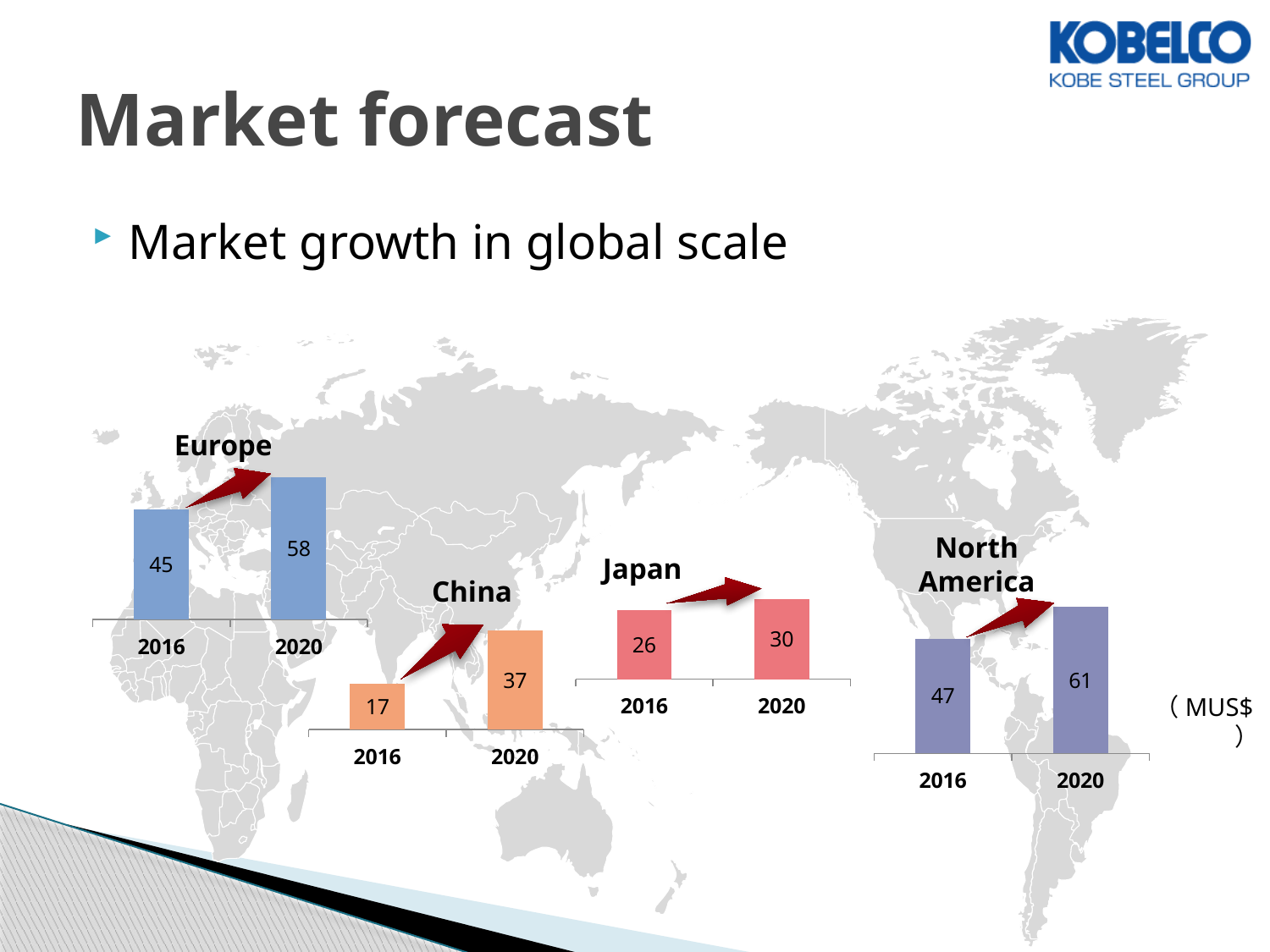
In the Europe chart, what is the value for 2020? 58 How many bars does the China chart show? 2 In the Europe chart, do the values rise or fall from 2016 to 2020? rise In the North America chart, what is the difference between the 2020 and 2016 values? 14 In the Japan chart, which year has the larger value, 2016 or 2020? 2020 What kind of chart is the North America chart? bar chart In the North America chart, what is the value for 2020? 61 In the China chart, what is the difference between the 2020 and 2016 values? 20 In the Japan chart, what is the value for 2016? 26 In the Europe chart, what is the value for 2016? 45 In the China chart, what is the value for 2020? 37 What unit is shown for the values on the slide? MUS$